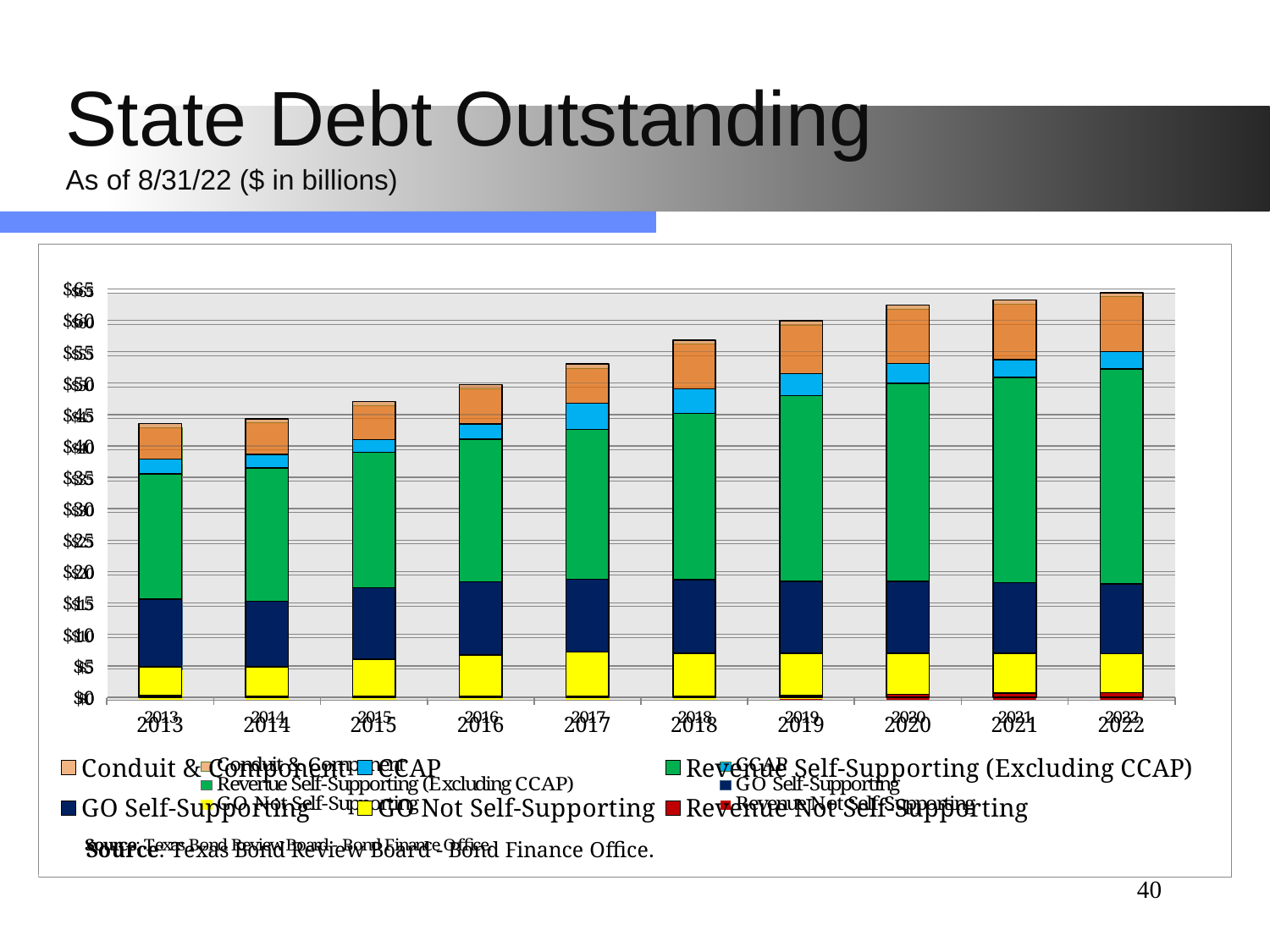
What is the title of the chart on the slide? State Debt Outstanding Is the total state debt outstanding for 2018 greater or less than $55? greater What kind of chart is shown on the slide? stacked bar chart Is the total state debt outstanding for 2022 greater or less than $60? greater Which series is shown in yellow in the chart? GO Not Self-Supporting How many series does the chart's legend list? 6 Is the total state debt outstanding for 2013 greater or less than $45? less Which year has the lowest total state debt outstanding? 2013 Which year has a taller total bar, 2015 or 2018? 2018 Do the total bar heights generally rise or fall from 2013 to 2022? rise Which year has the highest total state debt outstanding? 2022 How many years are shown on the x axis of the chart? 10